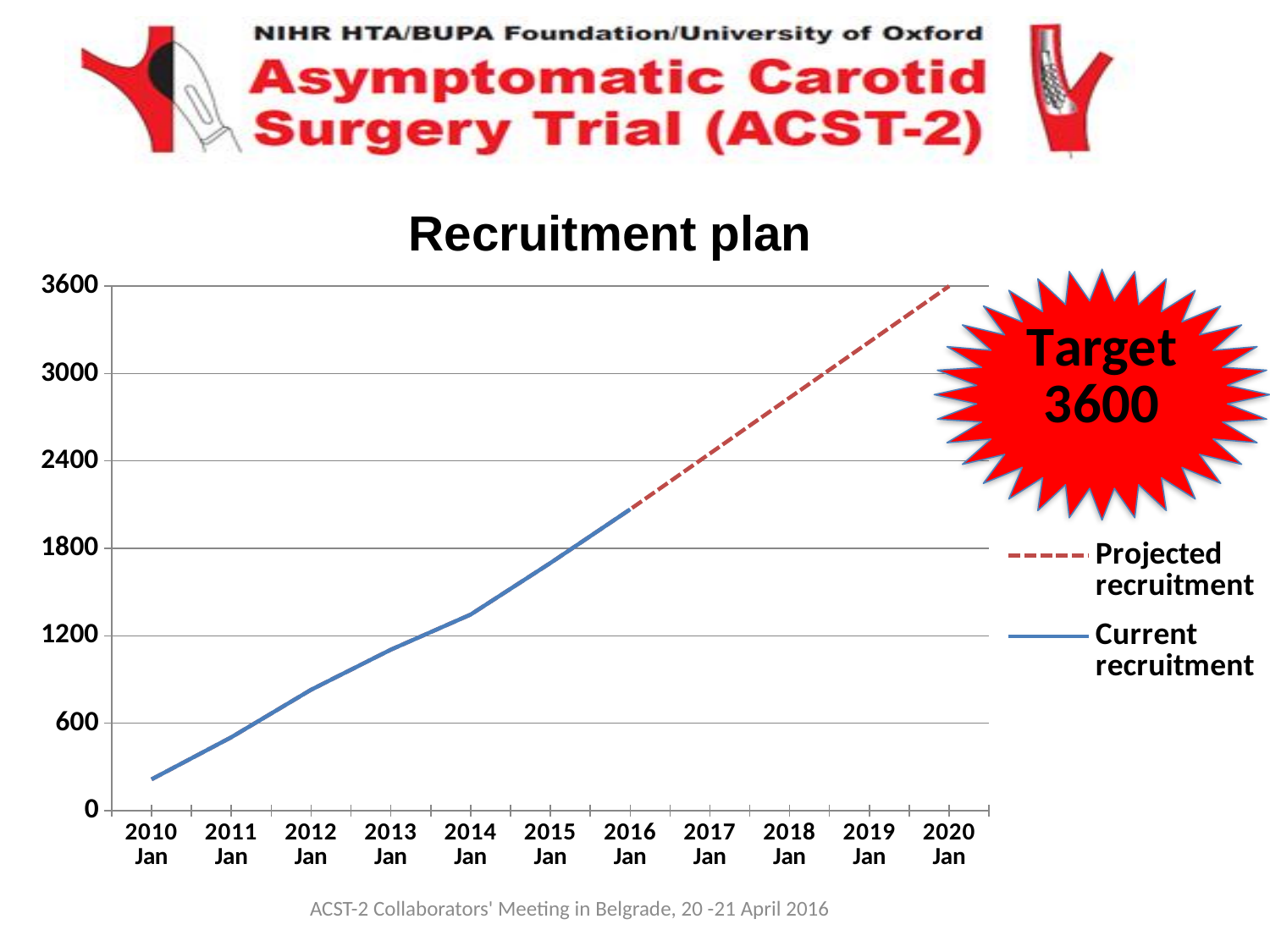
Which series is drawn as a dashed line in the chart? Projected recruitment How many year labels are shown along the x axis of the chart? 11 Which is larger: the Current recruitment value at 2016 Jan or the Current recruitment value at 2012 Jan? 2016 Jan Is the Projected recruitment value at 2018 Jan greater or less than 2400? greater Is the Current recruitment value at 2010 Jan greater or less than 600? less Is the Current recruitment value at 2014 Jan greater or less than 1200? greater How many series does the chart legend list? 2 What kind of chart is shown on the slide? line chart What value does the Projected recruitment line reach at 2020 Jan? 3600 What is the title of the chart? Recruitment plan Does the Current recruitment line rise or fall from 2010 Jan to 2016 Jan? rise